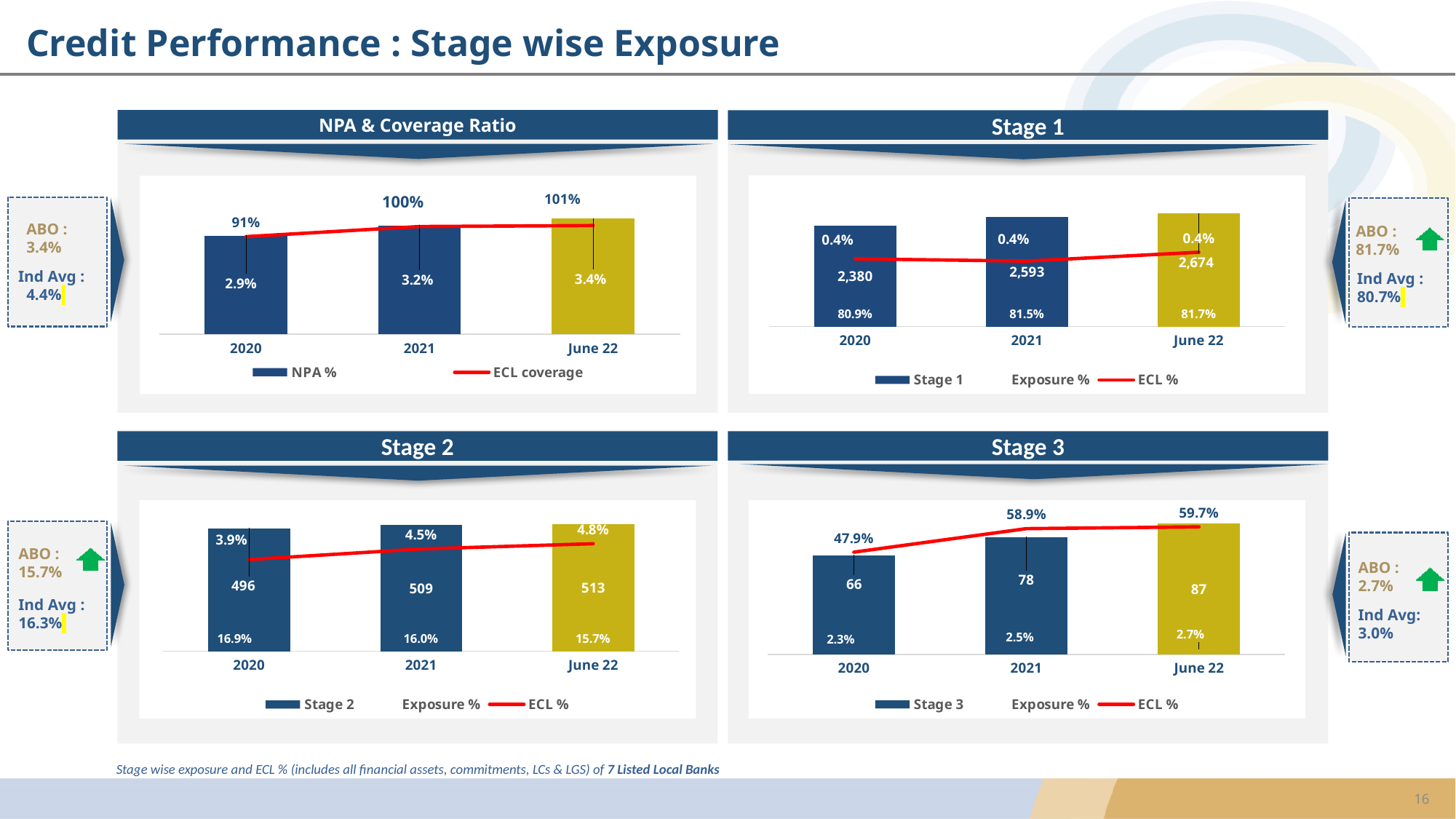
In the Stage 2 chart, what is the ECL % for 2021? 4.5% In the Stage 1 chart, what is the difference between the June 22 bar value and the 2020 bar value? 294 In the Stage 2 chart, which year has the highest bar value? June 22 In the Stage 1 chart, what is the bar value for 2021? 2,593 In the NPA & Coverage Ratio chart, what is the NPA % for 2021? 3.2% In the Stage 3 chart, what is the bar value for 2020? 66 In the Stage 3 chart, which is larger, the ECL % for 2021 or for 2020? 2021 How many categories are shown on the x axis of the Stage 2 chart? 3 In the NPA & Coverage Ratio chart, what is the ECL coverage value for June 22? 101% In the NPA & Coverage Ratio chart, does the NPA % rise or fall from 2020 to June 22? rise In the Stage 3 chart, what is the difference between the bar values for June 22 and 2021? 9 In the Stage 1 chart, what is the ECL % for 2020? 0.4%